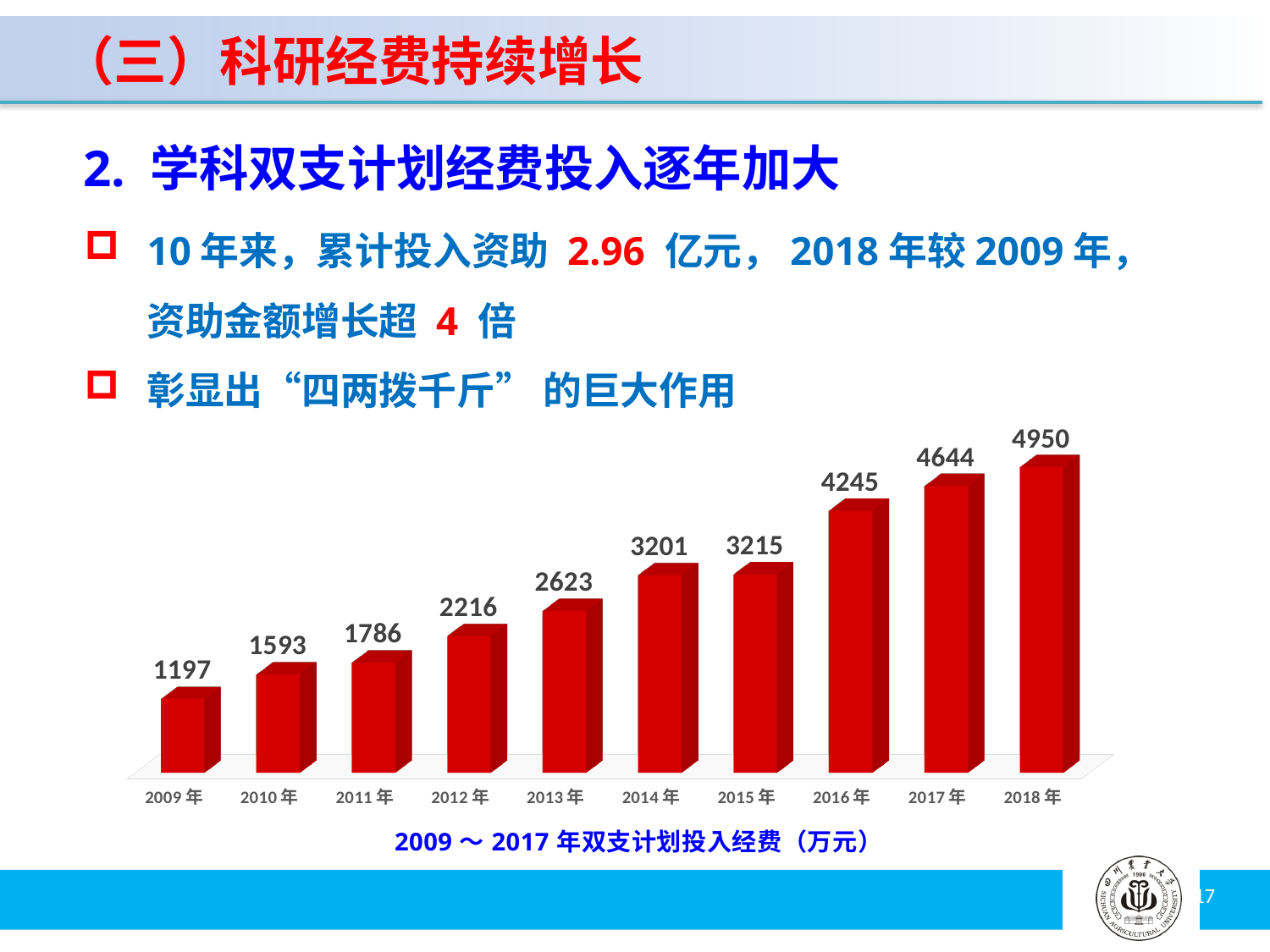
How many years are shown on the x axis? 10 What is the value for 2009年? 1197 What is the value for 2013年? 2623 What is the value for 2016年? 4245 Do the values rise or fall from 2009年 to 2018年? rise What is the difference between the values for 2017年 and 2016年? 399 Which is larger, the value for 2012年 or the value for 2011年? 2012年 What kind of chart is shown? bar chart What is the difference between the values for 2018年 and 2009年? 3753 What is the caption below the chart? 2009～2017年双支计划投入经费（万元） Which year has the lowest value? 2009年 Which year has the highest value? 2018年